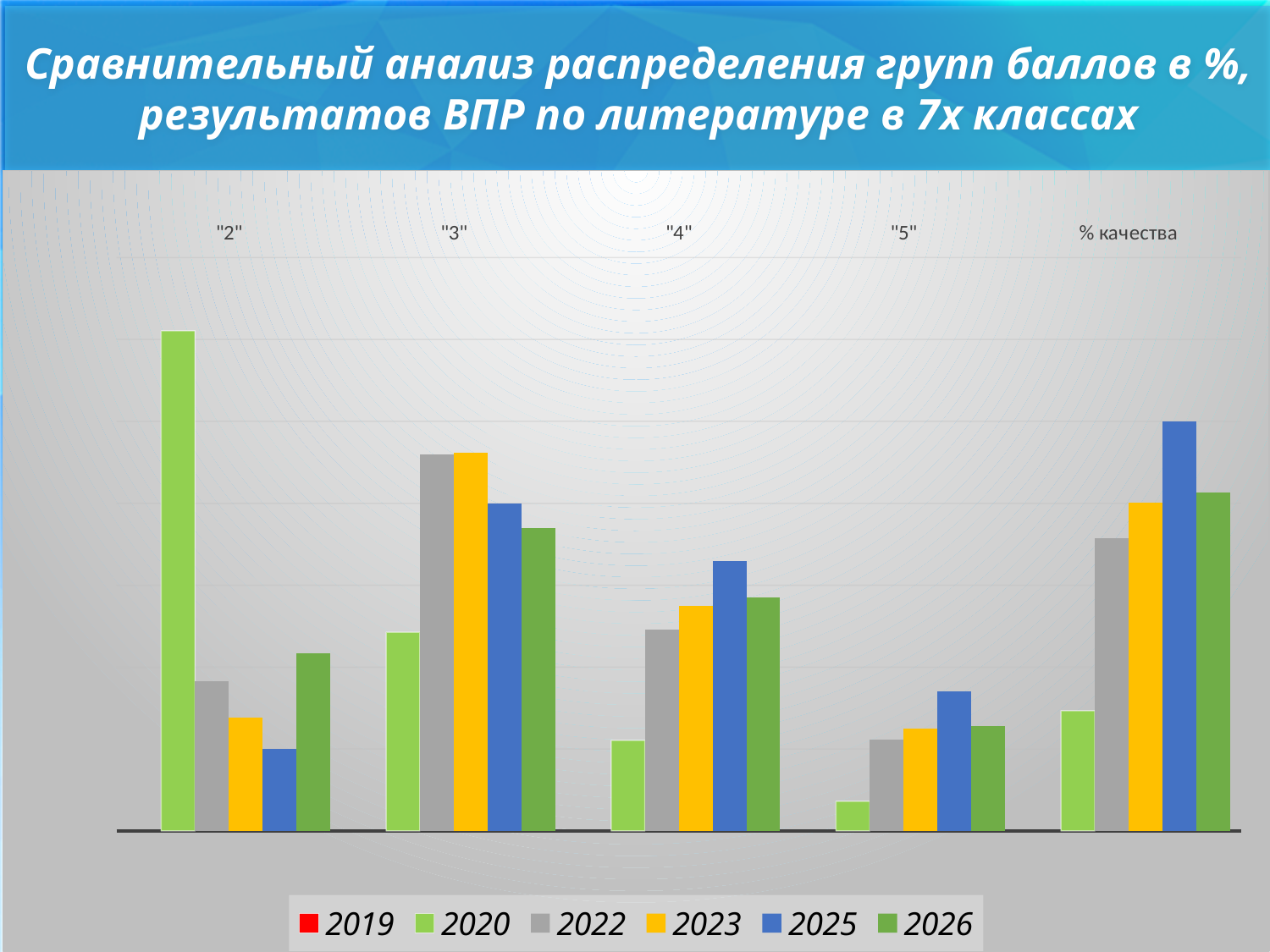
What kind of chart is shown on the slide? bar chart In the "4" category, which year has the highest bar? 2025 In the "2" category, which is larger: the bar for 2023 or the bar for 2026? 2026 In the "3" category, which year has the lowest bar? 2020 In the "2" category, which year has the lowest bar? 2025 In the "5" category, which year has the lowest bar? 2020 In the "4" category, which is larger: the bar for 2022 or the bar for 2023? 2023 Which year in the legend is shown in red? 2019 How many series does the legend list? 6 How many categories are shown along the x axis? 5 In the "2" category, which year has the highest bar? 2020 In the "% качества" category, which year has the highest bar? 2025